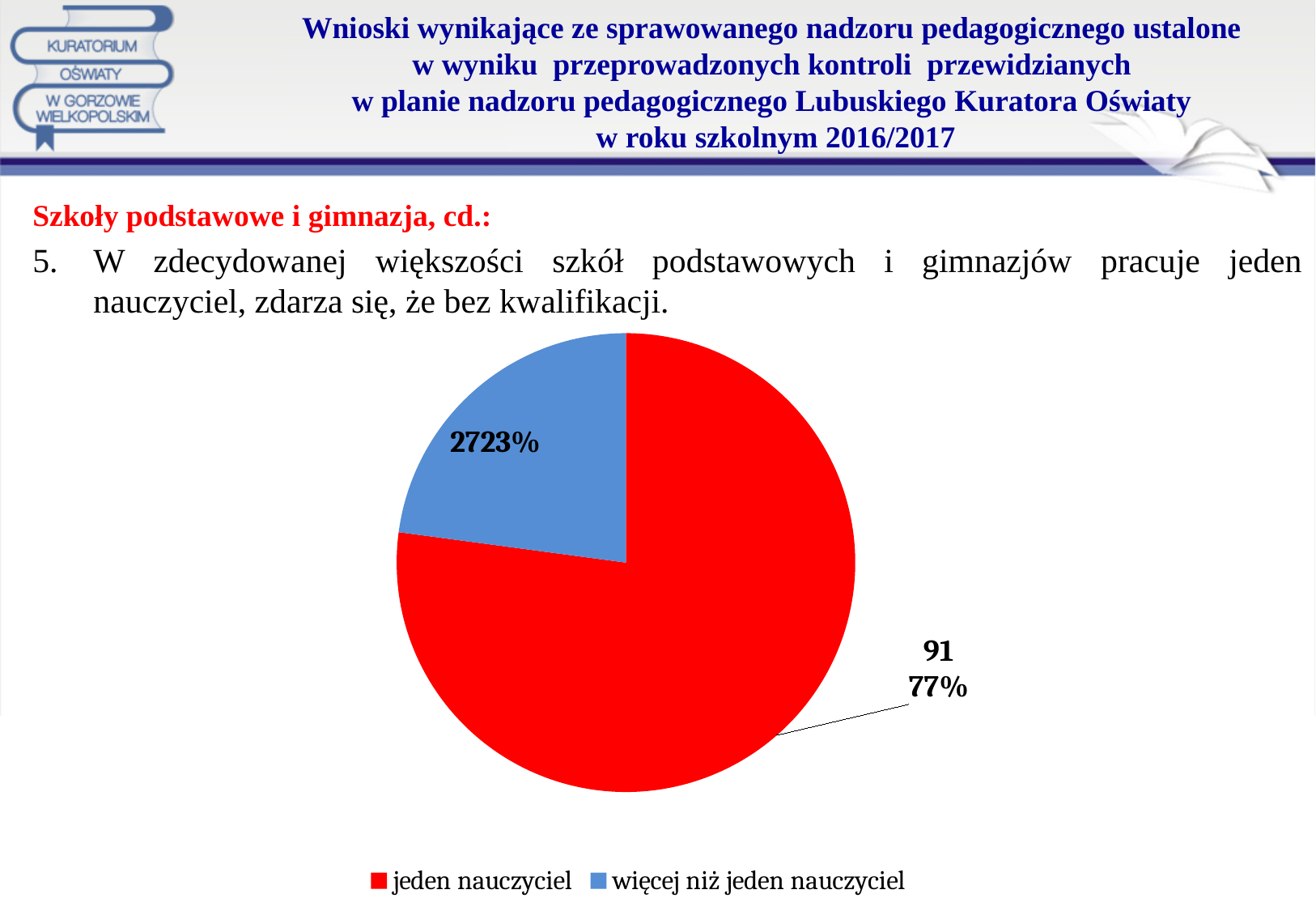
What colour is the 'jeden nauczyciel' slice in the pie chart? red What share of the pie does the 'jeden nauczyciel' slice represent? 77% Which is larger: the 'jeden nauczyciel' slice or the 'więcej niż jeden nauczyciel' slice? jeden nauczyciel What type of chart is shown on the slide? pie chart What are the two legend entries of the pie chart? jeden nauczyciel; więcej niż jeden nauczyciel What share of the pie does the 'więcej niż jeden nauczyciel' slice represent? 23% Which slice of the pie chart is the smallest? więcej niż jeden nauczyciel How many slices does the pie chart have? 2 Which slice of the pie chart is the largest? jeden nauczyciel How many entries does the legend of the pie chart list? 2 What value is shown for the 'jeden nauczyciel' slice? 91